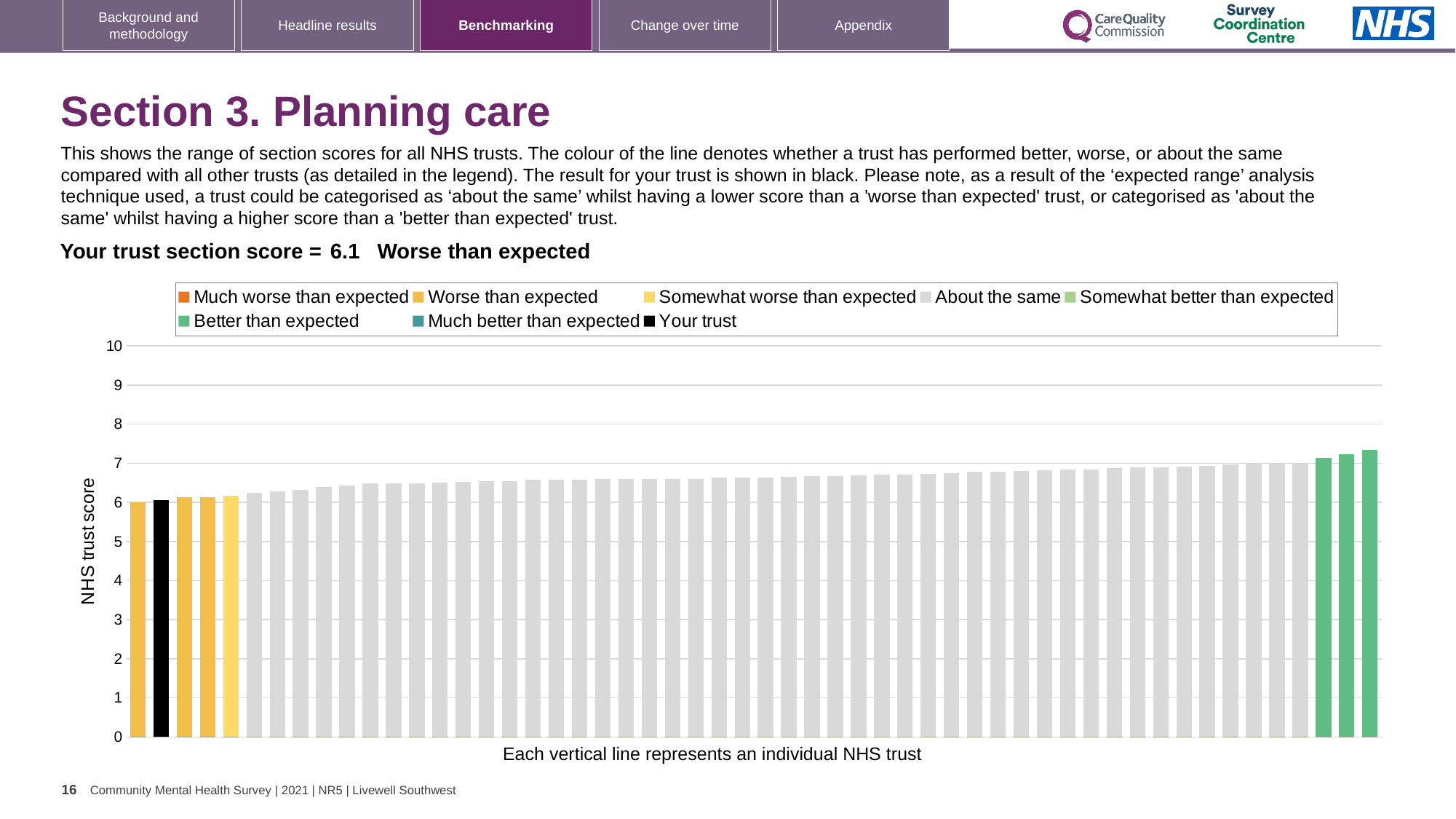
How many entries does the chart legend list? 8 Is the value of the tallest bar in the chart greater or less than 7? greater How many bars are coloured green (better than expected) in the chart? 3 Is the value for your trust greater or less than 7? less Is the value for your trust greater or less than 5? greater Which category is your trust placed in for this section? Worse than expected What is the section score for your trust shown on the slide? 6.1 What colour is the bar representing your trust in the chart? black What kind of chart is shown on the slide? bar chart Do the bar values rise or fall from left to right along the x axis? rise What is the label on the vertical axis of the chart? NHS trust score